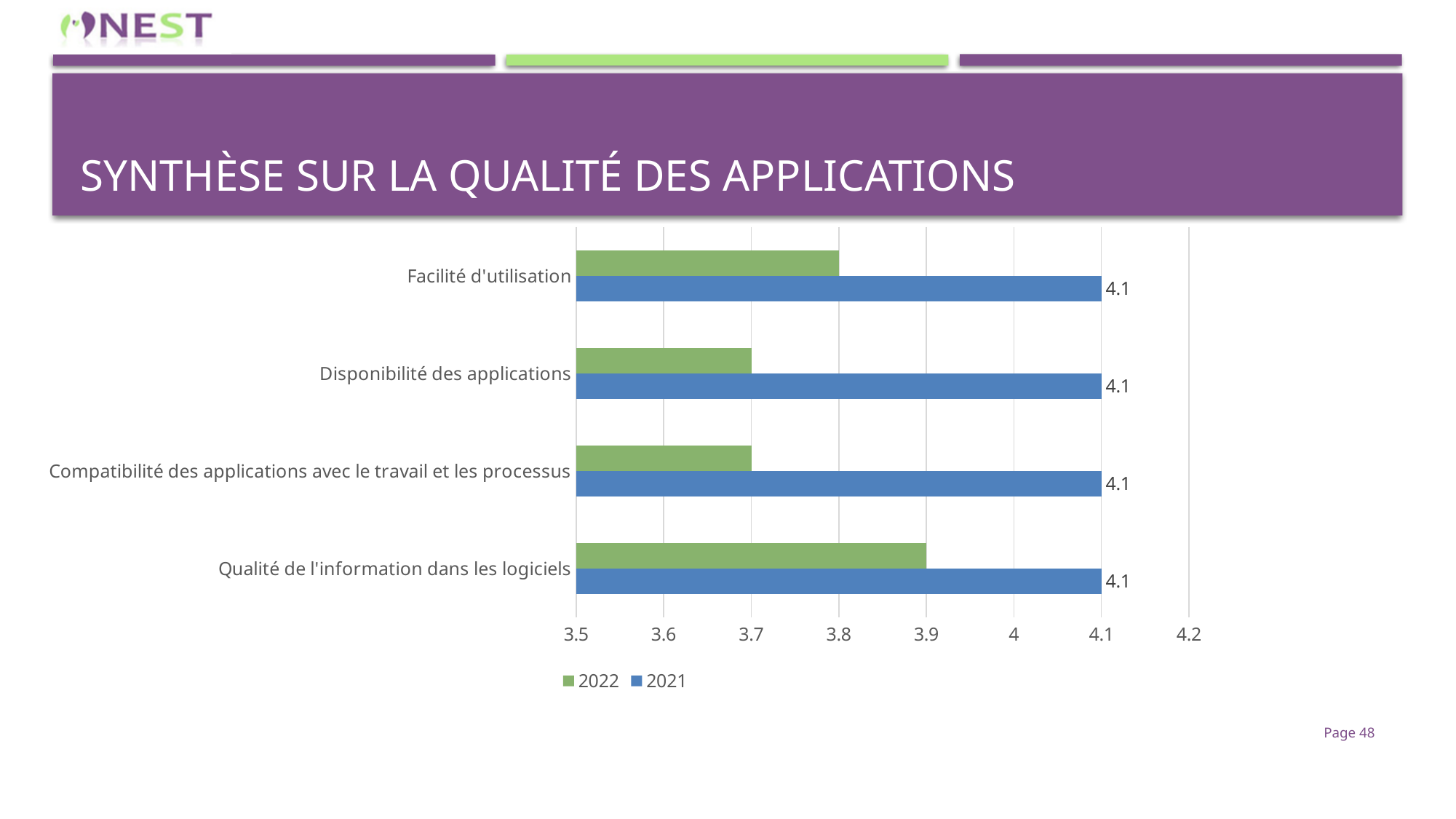
For Compatibilité des applications avec le travail et les processus, which year has the larger value, 2021 or 2022? 2021 What is the 2021 value for Facilité d'utilisation? 4.1 How many series does the legend list? 2 Is the 2022 value for Disponibilité des applications greater or less than 3.8? less Which colour represents the 2022 series in the legend? green What is the 2022 value for Qualité de l'information dans les logiciels? 3.9 What type of chart is shown on the slide? bar chart How many categories are shown on the chart? 4 What is the 2022 value for Facilité d'utilisation? 3.8 What is the 2021 value for Qualité de l'information dans les logiciels? 4.1 Which category has the highest 2022 value? Qualité de l'information dans les logiciels What is the difference between the 2021 and 2022 values for Facilité d'utilisation? 0.3